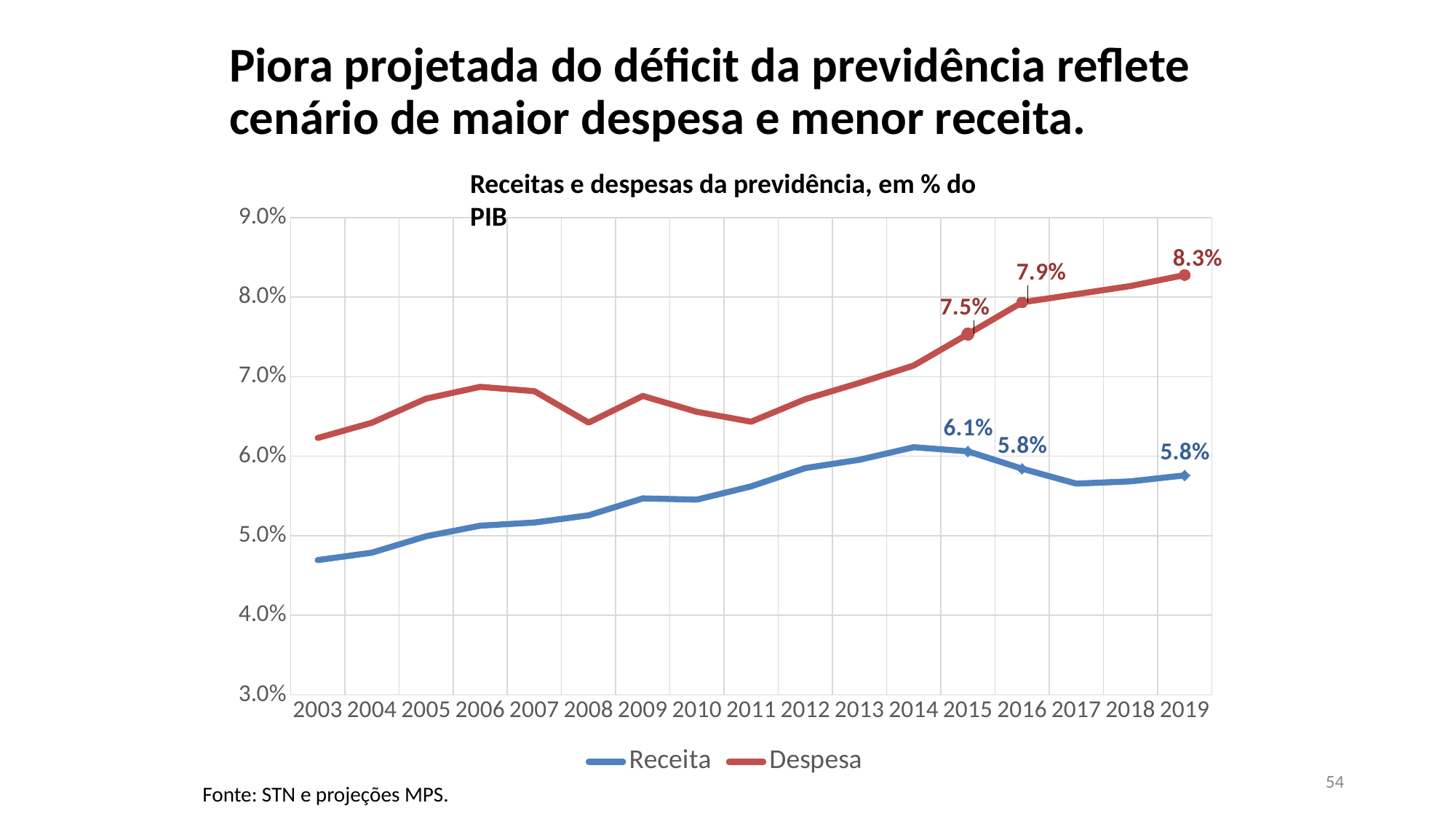
Which is larger in 2015, Receita or Despesa? Despesa What is the value of Despesa in 2019? 8.3% What is the value of Receita in 2019? 5.8% What kind of chart is shown on the slide? Line chart How many years are shown on the x axis? 17 How many series does the legend list? 2 What is the value of Despesa in 2016? 7.9% What is the difference between Despesa and Receita in 2019? 2.5 percentage points What is the value of Receita in 2015? 6.1% In which year does Despesa reach its highest value? 2019 Is the value for Despesa in 2003 greater or less than 6.0%? greater Is the value for Receita in 2003 greater or less than 5.0%? less